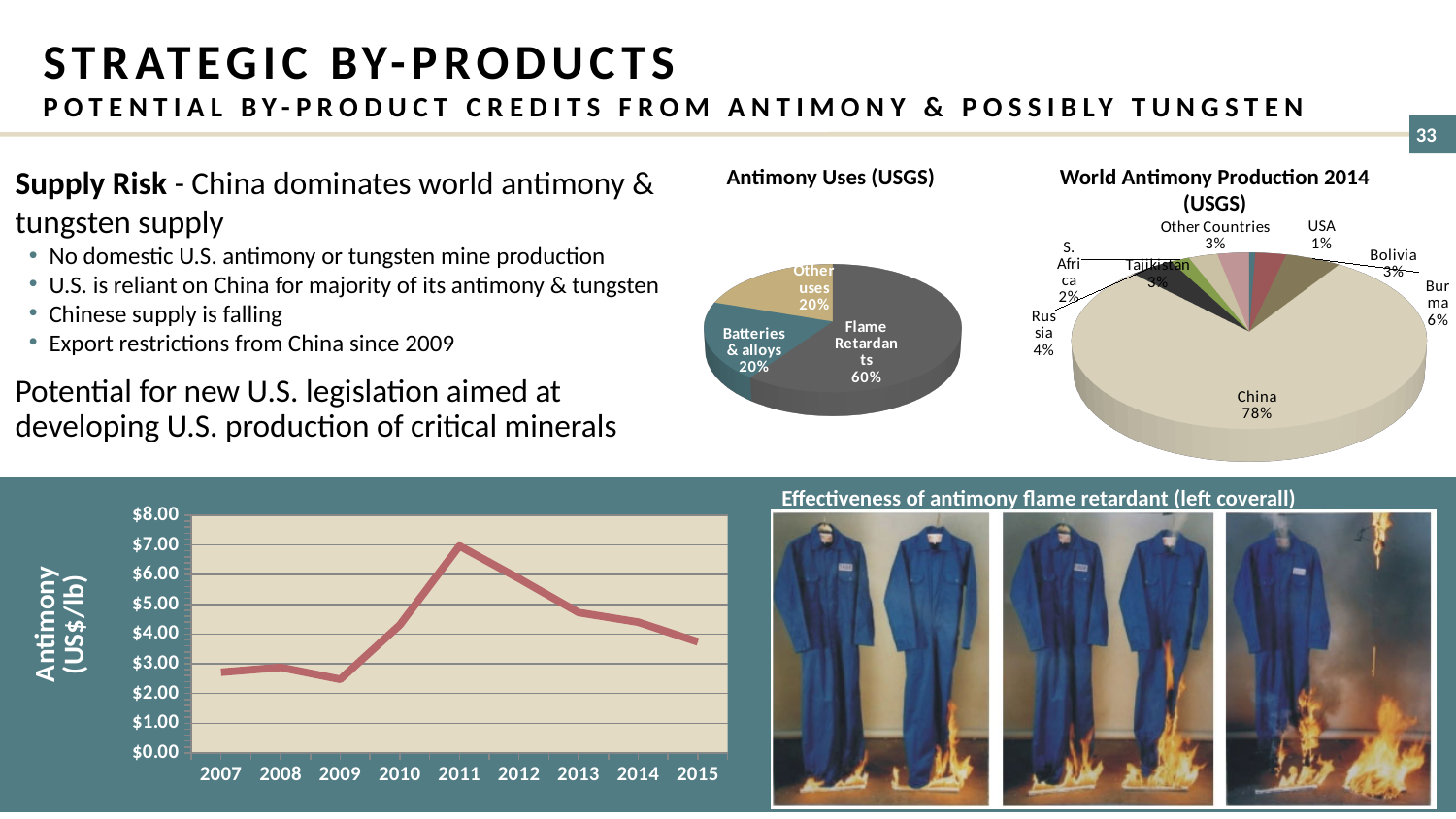
How many slices does the World Antimony Production 2014 (USGS) pie chart have? 8 In the World Antimony Production 2014 (USGS) chart, what share of production is China? 78% In the Antimony (US$/lb) line chart, which year has the highest price? 2011 What kind of chart is the Antimony (US$/lb) chart at the bottom left of the slide? Line chart In the World Antimony Production 2014 (USGS) chart, which is larger, Burma or Bolivia? Burma In the Antimony Uses (USGS) chart, what percentage is Batteries & alloys? 20% In the Antimony (US$/lb) line chart, do the values rise or fall from 2011 to 2015? Fall In the Antimony (US$/lb) line chart, is the value for 2011 greater or less than $6.00? greater How many slices does the Antimony Uses (USGS) pie chart have? 3 In the World Antimony Production 2014 (USGS) chart, what is the difference between Burma's share and Russia's share? 2% In the Antimony Uses (USGS) chart, what share of antimony use is Flame Retardants? 60% In the World Antimony Production 2014 (USGS) chart, which country has the smallest share? USA